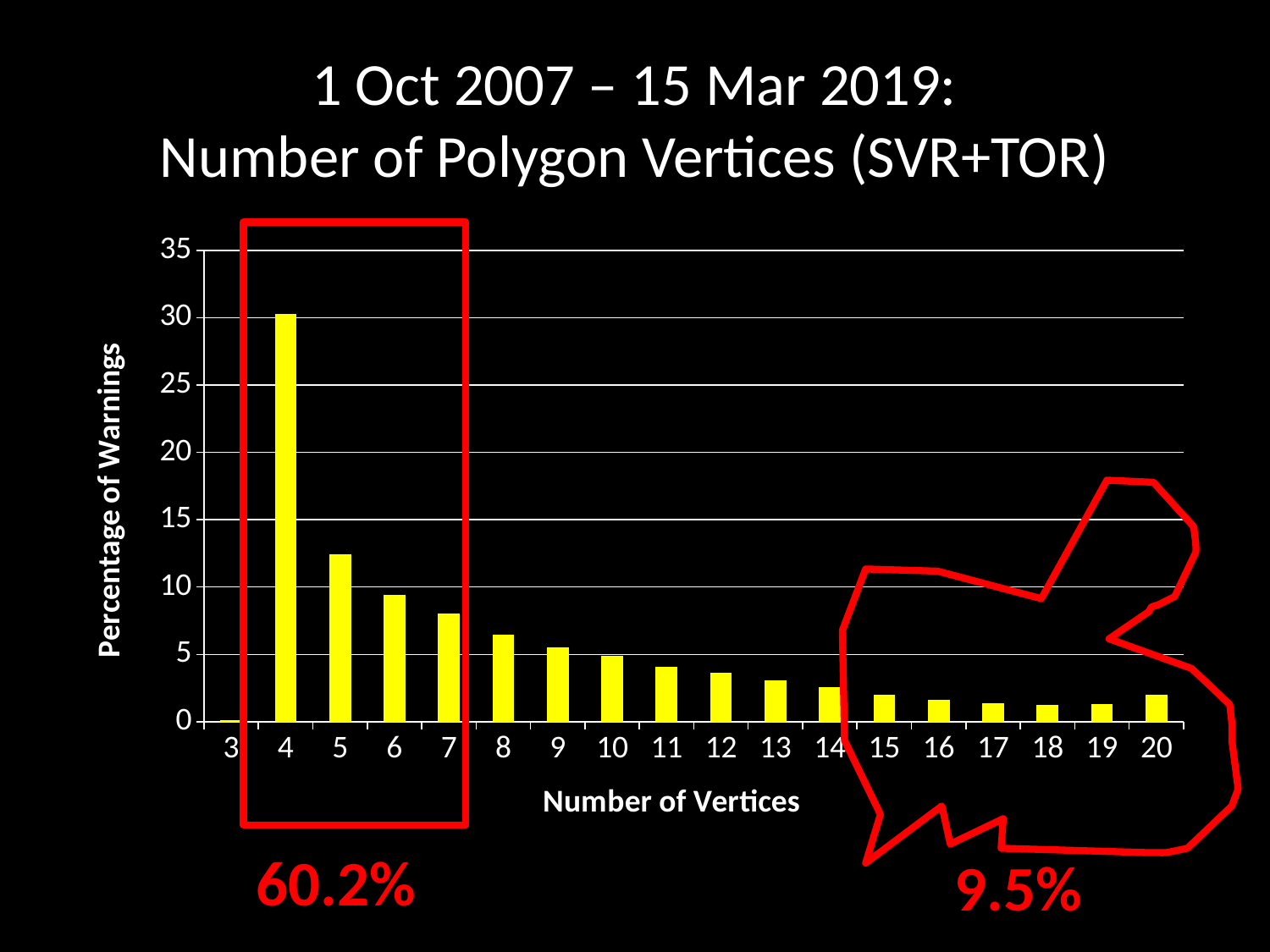
What is the label on the y axis? Percentage of Warnings Which number of vertices has the lowest percentage of warnings? 3 From 4 vertices to 14 vertices, do the percentages rise or fall as the number of vertices increases? fall How many vertex-count categories are plotted along the x axis? 18 Is the percentage of warnings for 4 vertices greater or less than 25? greater Which number of vertices has the highest percentage of warnings? 4 What percentage is annotated for the red box around 4 to 7 vertices? 60.2% Is the percentage of warnings for 5 vertices greater or less than 10? greater Which has a higher percentage of warnings, 5 vertices or 6 vertices? 5 vertices Is the percentage of warnings for 13 vertices greater or less than 5? less What kind of chart is shown on the slide? bar chart